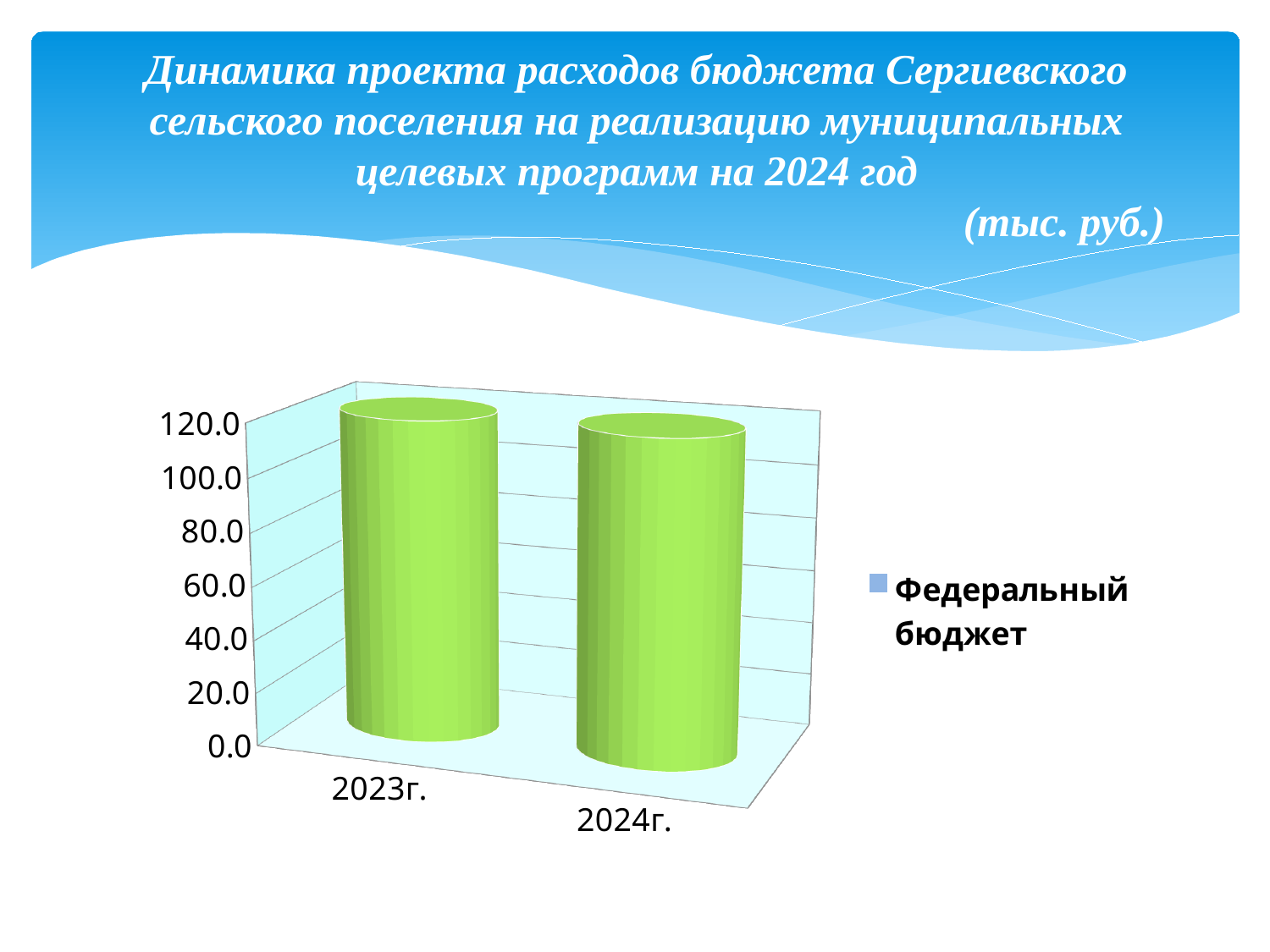
How many categories are shown on the x axis of the chart? 2 How many series does the chart legend list? 1 Is the value for 2023г. greater or less than 80.0? greater What is the highest tick value shown on the vertical axis of the chart? 120.0 What kind of chart is shown on the slide? bar chart Is the value for 2023г. greater or less than 40.0? greater What series name is shown in the chart legend? Федеральный бюджет Is the value for 2024г. greater or less than 60.0? greater